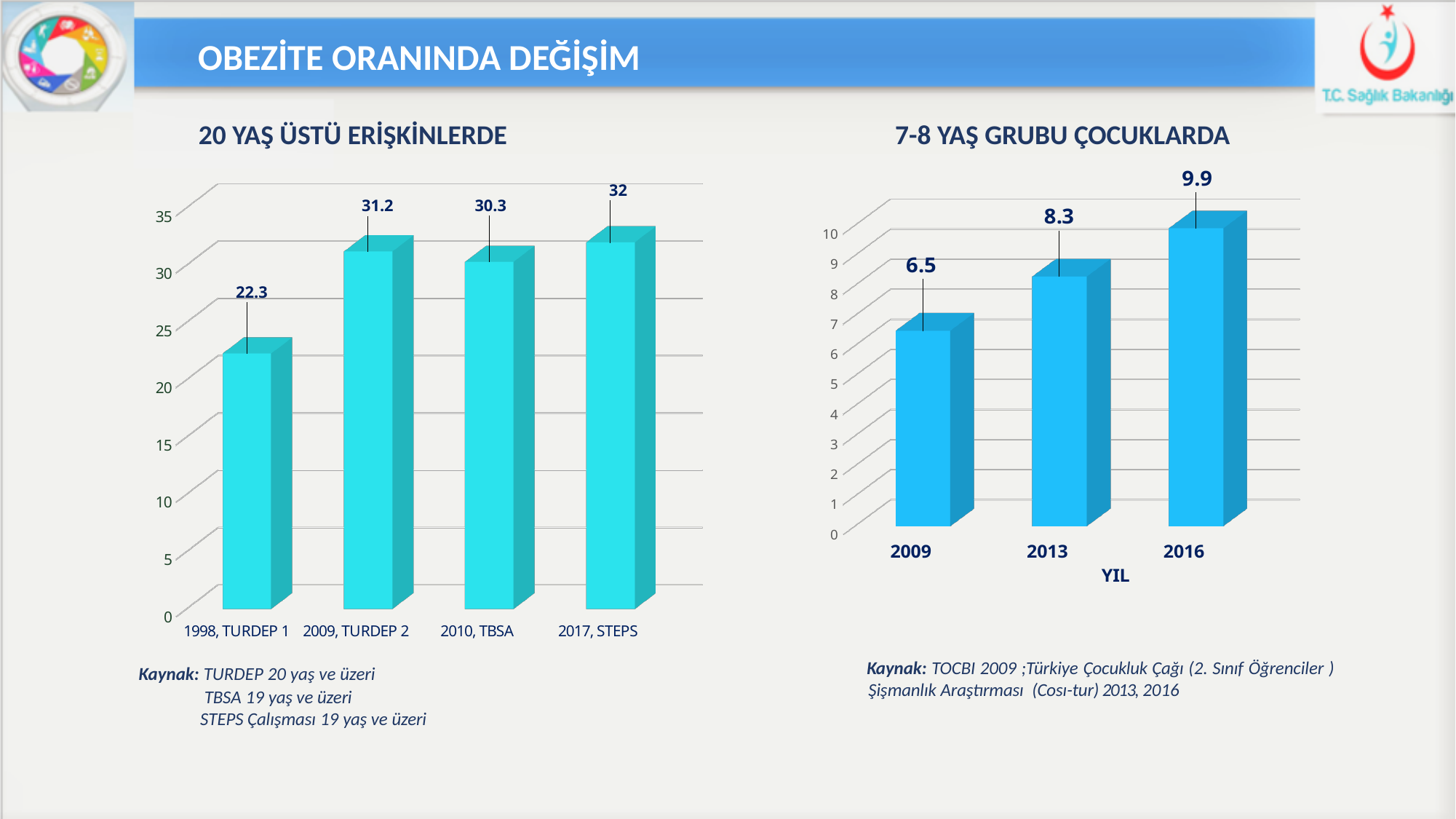
What kind of chart is the '7-8 YAŞ GRUBU ÇOCUKLARDA' chart? bar chart In the '20 YAŞ ÜSTÜ ERİŞKİNLERDE' chart, what is the difference between the values for 2009, TURDEP 2 and 1998, TURDEP 1? 8.9 In the '20 YAŞ ÜSTÜ ERİŞKİNLERDE' chart, which category has the lowest value? 1998, TURDEP 1 In the '20 YAŞ ÜSTÜ ERİŞKİNLERDE' chart, how many categories are shown? 4 In the '20 YAŞ ÜSTÜ ERİŞKİNLERDE' chart, what is the value for 1998, TURDEP 1? 22.3 In the '20 YAŞ ÜSTÜ ERİŞKİNLERDE' chart, which category has the highest value? 2017, STEPS In the '7-8 YAŞ GRUBU ÇOCUKLARDA' chart, what is the value for 2016? 9.9 In the '20 YAŞ ÜSTÜ ERİŞKİNLERDE' chart, what is the value for 2010, TBSA? 30.3 In the '7-8 YAŞ GRUBU ÇOCUKLARDA' chart, what is the label of the x axis? YIL In the '7-8 YAŞ GRUBU ÇOCUKLARDA' chart, what is the difference between the values for 2016 and 2009? 3.4 In the '7-8 YAŞ GRUBU ÇOCUKLARDA' chart, do the values rise or fall from 2009 to 2016? rise In the '7-8 YAŞ GRUBU ÇOCUKLARDA' chart, what is the value for 2013? 8.3